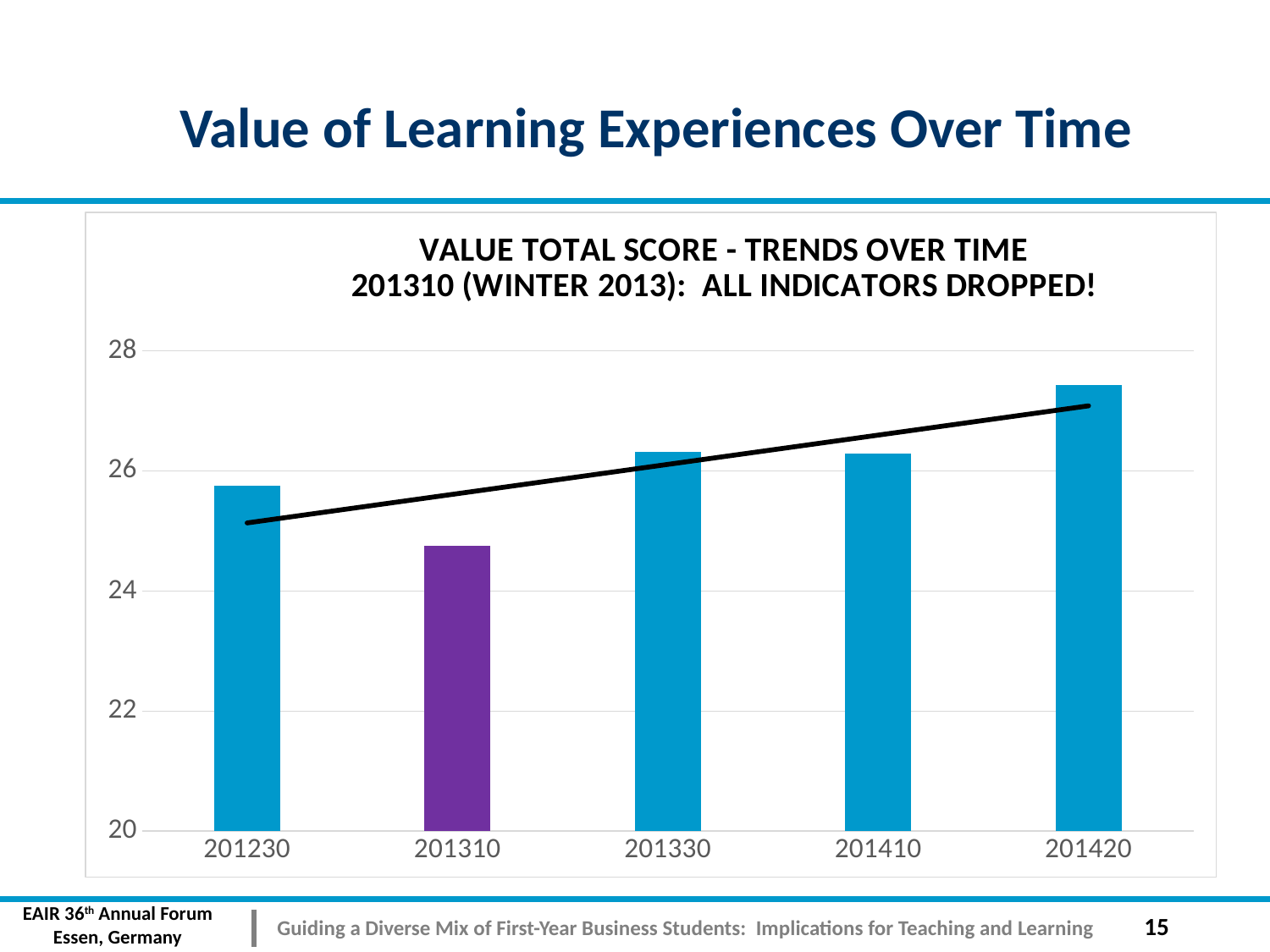
Which term's bar is coloured purple instead of blue? 201310 How many terms (categories) are shown on the x axis of the chart? 5 Which term has the lowest value total score? 201310 Is the value for 201420 greater or less than 26? greater Is the value for 201310 greater or less than 26? less Is the value for 201310 greater or less than 24? greater What kind of chart is shown on the slide? Bar chart According to the trend line drawn on the chart, do the values generally rise or fall over time? Rise Which is larger, the value for 201420 or the value for 201230? 201420 Which term has the highest value total score? 201420